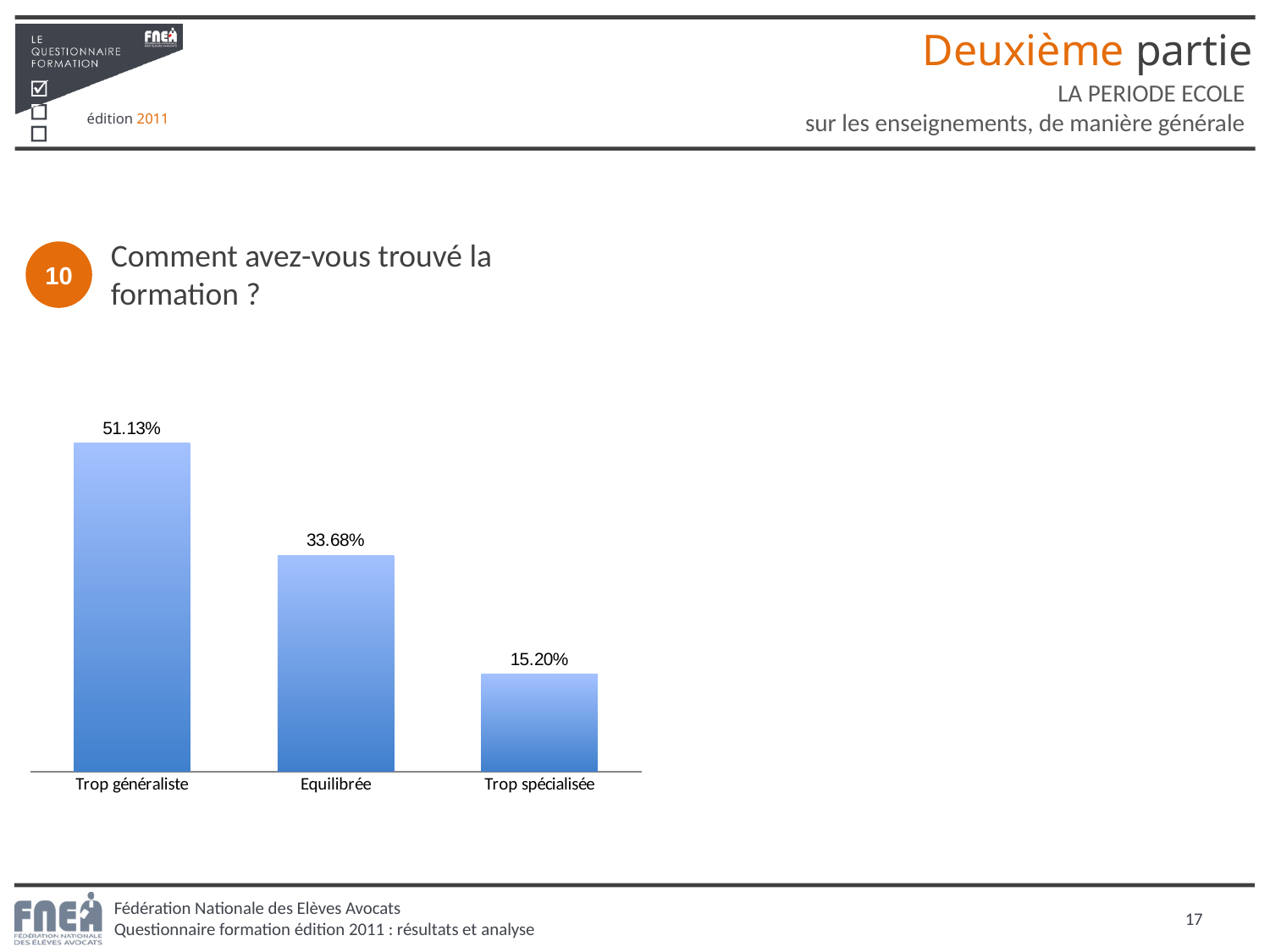
What is the value for Equilibrée? 33.68% Do the values rise or fall from left to right along the x axis? Fall What is the difference between the values for Equilibrée and Trop spécialisée? 18.48% Which category has the lowest value? Trop spécialisée What is the difference between the values for Trop généraliste and Equilibrée? 17.45% What is the value for Trop spécialisée? 15.20% What question does the chart on the slide answer? Comment avez-vous trouvé la formation ? What kind of chart is shown on the slide? Bar chart How many categories are shown in the chart? 3 Which category has the highest value? Trop généraliste What is the value for Trop généraliste? 51.13% Which is larger, the value for Equilibrée or the value for Trop spécialisée? Equilibrée